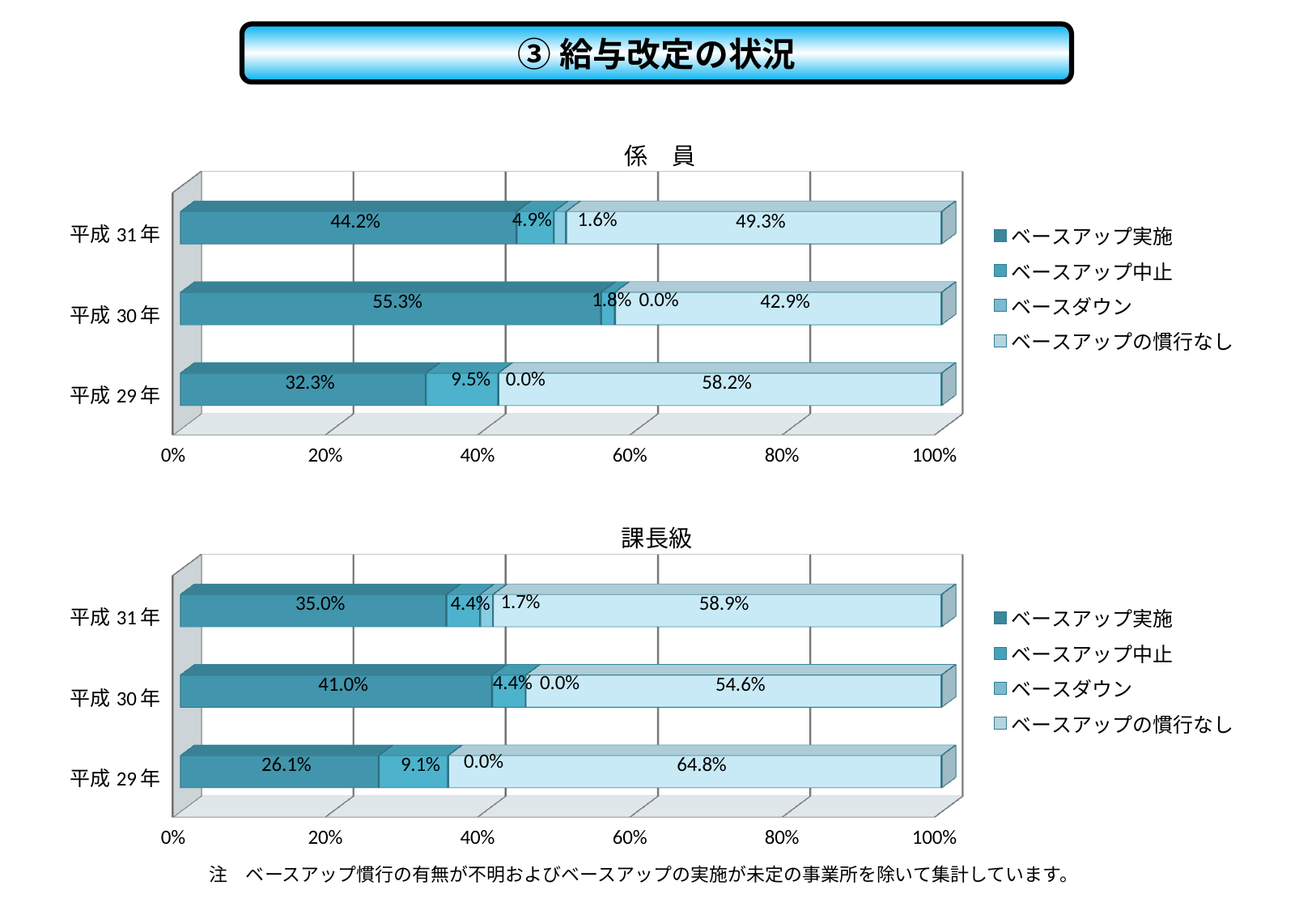
In the 課長級 chart, what is the value of ベースダウン for 平成 31 年? 1.7% What is the title of the bottom chart on the slide? 課長級 In the 係員 chart, what is the difference between the ベースアップ実施 values for 平成 30 年 and 平成 29 年? 23.0% In the 係員 chart, what is the value of ベースアップの慣行なし for 平成 29 年? 58.2% In the 係員 chart, what is the value of ベースアップ実施 for 平成 31 年? 44.2% In the 課長級 chart, what is the value of ベースアップ中止 for 平成 29 年? 9.1% What kind of chart is the 係員 chart? Stacked bar chart In the 課長級 chart, which is larger: ベースアップ実施 for 平成 31 年 or ベースアップ実施 for 平成 30 年? 平成 30 年 In the 課長級 chart, which year has the lowest value for ベースアップの慣行なし? 平成 30 年 How many years (categories) are shown in the 課長級 chart? 3 How many series does the legend of the 係員 chart list? 4 In the 係員 chart, which year has the highest value for ベースアップ実施? 平成 30 年